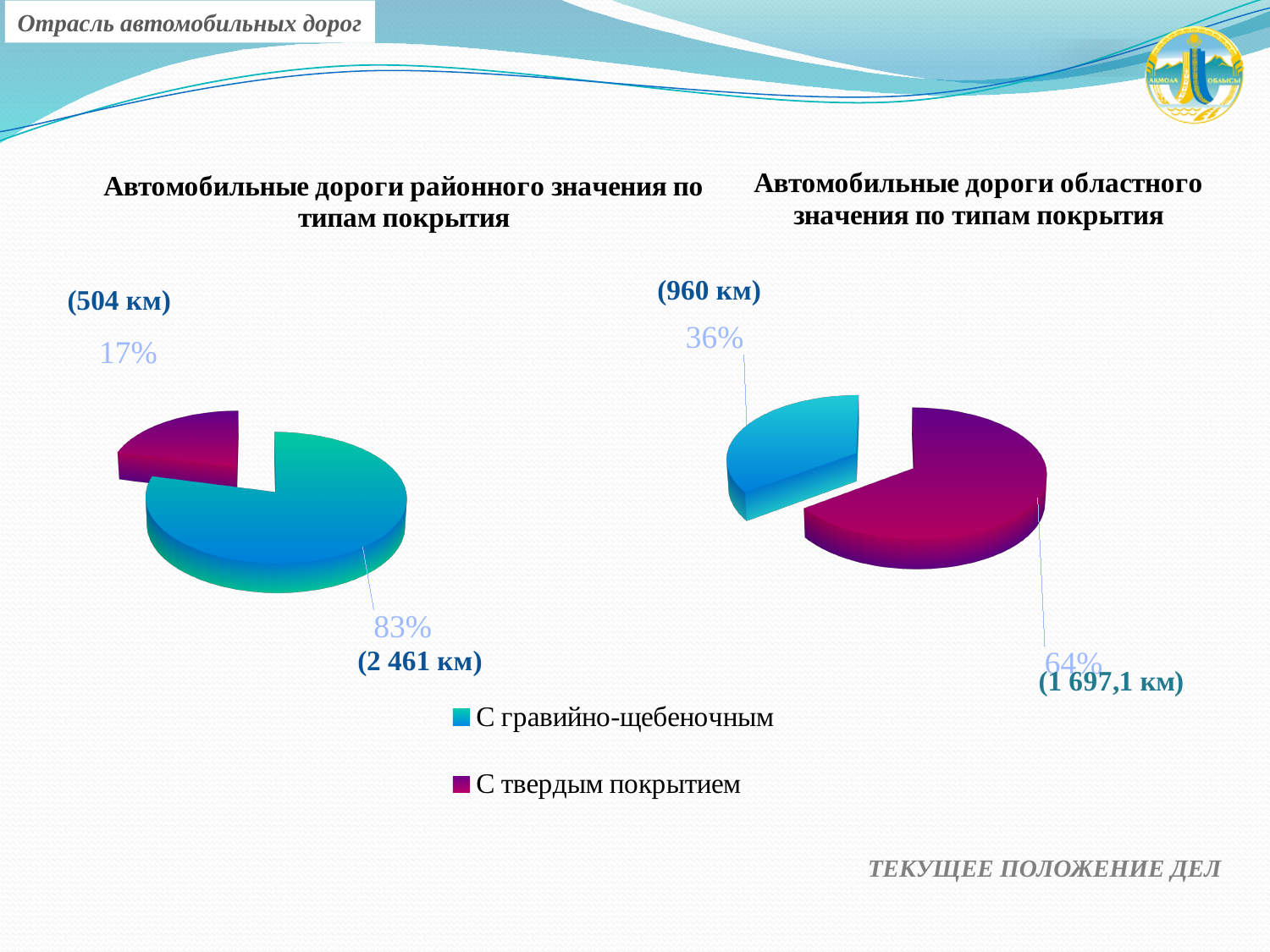
На диаграмме «Автомобильные дороги областного значения по типам покрытия» какова протяженность дорог с твердым покрытием? 1 697,1 км На диаграмме «Автомобильные дороги областного значения по типам покрытия» какой тип покрытия имеет наибольшую долю? С твердым покрытием На диаграмме «Автомобильные дороги областного значения по типам покрытия» какова протяженность дорог с гравийно-щебеночным покрытием? 960 км Сколько категорий перечислено в легенде диаграмм на слайде? 2 На диаграмме «Автомобильные дороги районного значения по типам покрытия» какова протяженность дорог с твердым покрытием? 504 км На диаграмме «Автомобильные дороги районного значения по типам покрытия» какой тип покрытия имеет наименьшую долю? С твердым покрытием На диаграмме «Автомобильные дороги районного значения по типам покрытия» какая доля приходится на дороги с твердым покрытием? 17% На диаграмме «Автомобильные дороги областного значения по типам покрытия» какая доля приходится на дороги с гравийно-щебеночным покрытием? 36% Какого типа диаграмма слева («Автомобильные дороги районного значения по типам покрытия»)? Круговая диаграмма На диаграмме «Автомобильные дороги районного значения по типам покрытия» какая доля приходится на дороги с гравийно-щебеночным покрытием? 83% На диаграмме «Автомобильные дороги районного значения по типам покрытия» какова протяженность дорог с гравийно-щебеночным покрытием? 2 461 км